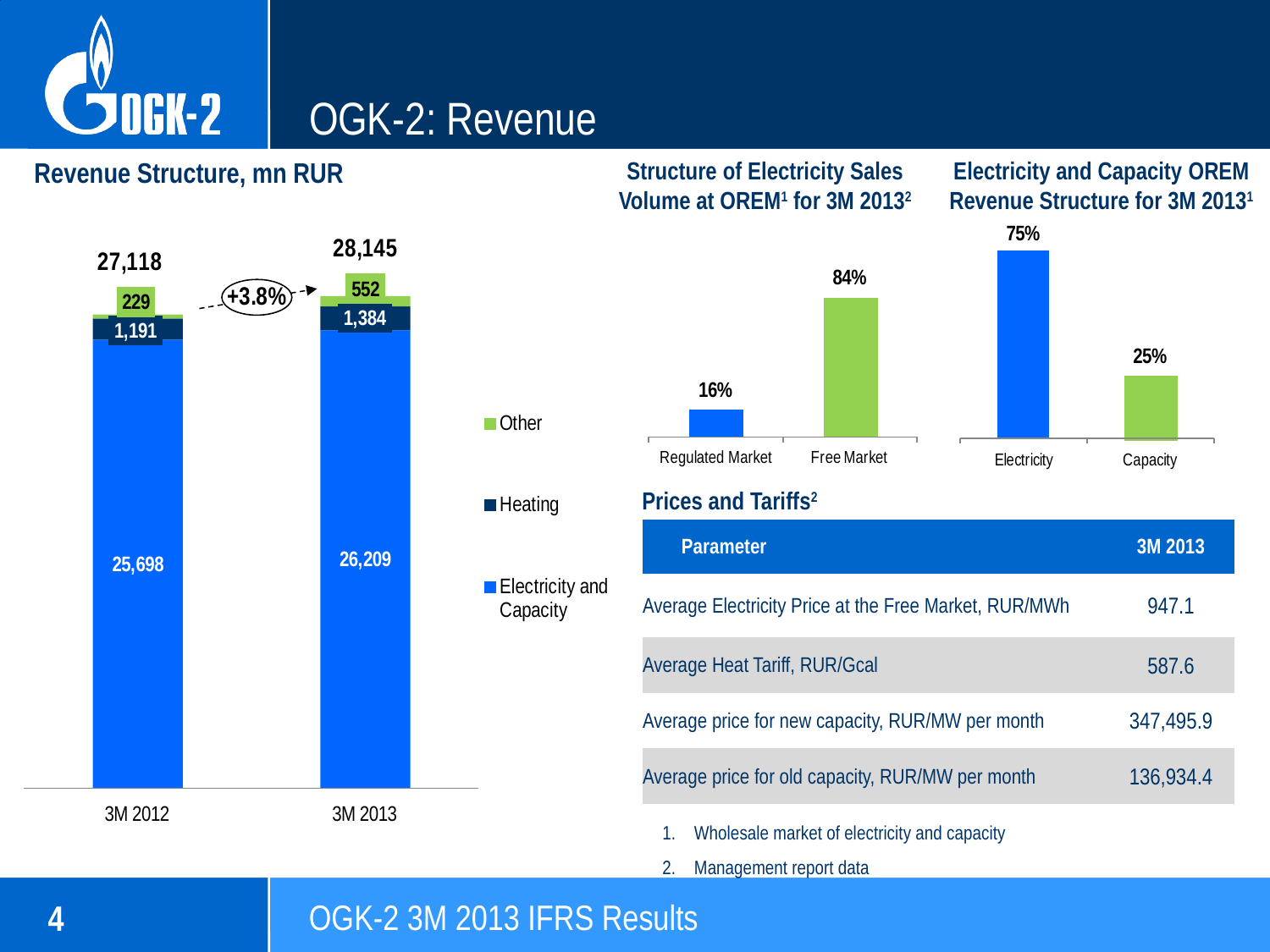
In the Structure of Electricity Sales Volume at OREM for 3M 2013 chart, what is the value for Free Market? 84% In the Electricity and Capacity OREM Revenue Structure for 3M 2013 chart, what is the value for Capacity? 25% In the Revenue Structure, mn RUR chart, what is the Electricity and Capacity value for 3M 2013? 26,209 What kind of chart is the Electricity and Capacity OREM Revenue Structure for 3M 2013 chart? Bar chart In the Revenue Structure, mn RUR chart, which period has the larger Heating value, 3M 2012 or 3M 2013? 3M 2013 In the Electricity and Capacity OREM Revenue Structure for 3M 2013 chart, what is the difference between Electricity and Capacity? 50% In the Revenue Structure, mn RUR chart, what is the Heating value for 3M 2012? 1,191 In the Revenue Structure, mn RUR chart, what is the difference between the Other values for 3M 2013 and 3M 2012? 323 In the Structure of Electricity Sales Volume at OREM for 3M 2013 chart, which category is lowest? Regulated Market In the Revenue Structure, mn RUR chart, how many series does the legend list? 3 In the Revenue Structure, mn RUR chart, what is the total of the 3M 2013 stacked bar? 28,145 In the Revenue Structure, mn RUR chart, what percentage change is shown between 3M 2012 and 3M 2013? +3.8%